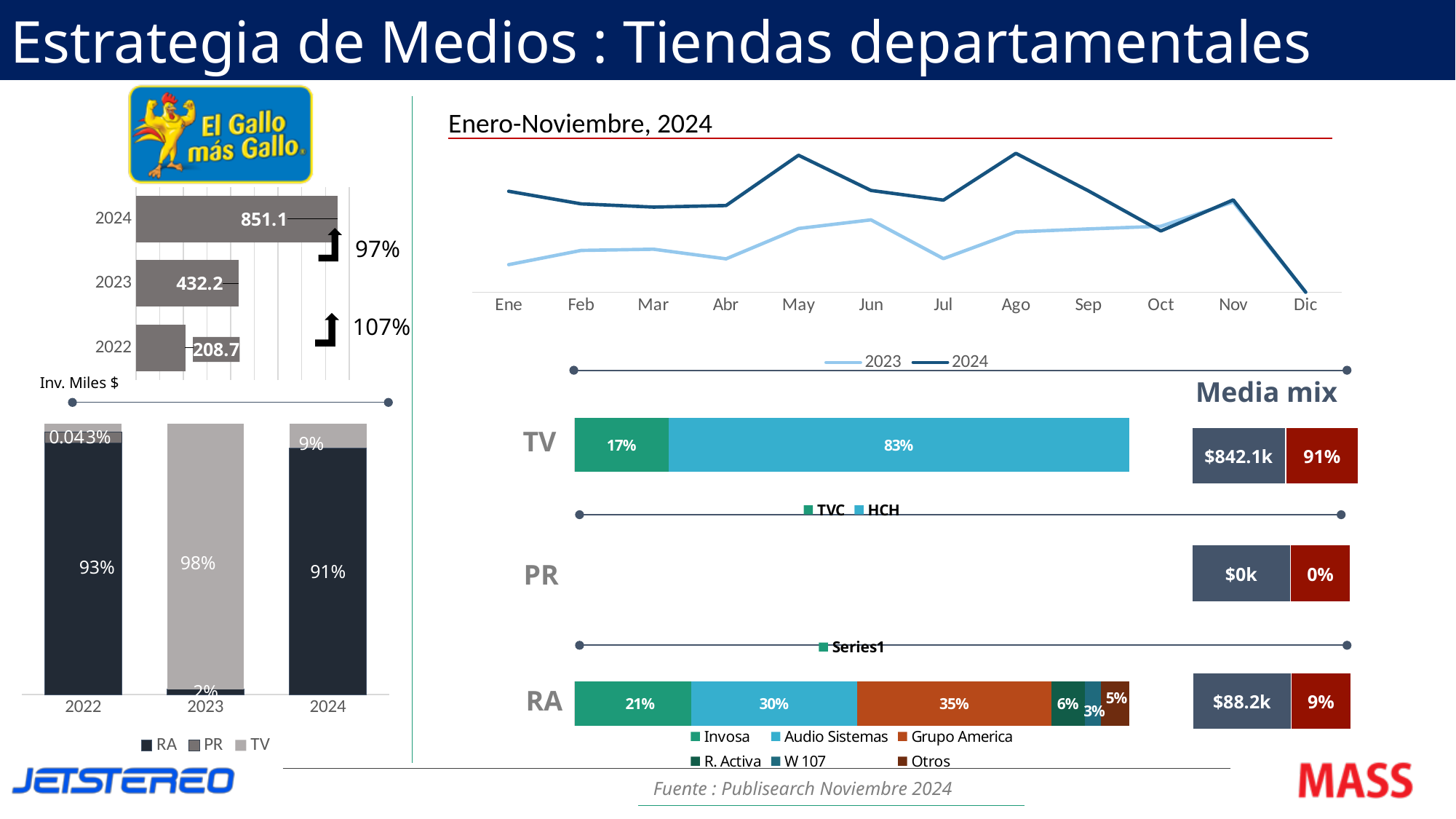
In the 'Inv. Miles $' bar chart on the left, what is the value for 2022? 208.7 In the RA stacked bar, which channel has the largest share? Grupo America In the Media mix boxes, what is the dollar amount shown for RA? $88.2k In the 'Inv. Miles $' bar chart on the left, what is the value for 2024? 851.1 In the stacked bar chart at the bottom left, what share does RA have in 2024? 91% In the 'Inv. Miles $' bar chart on the left, what is the difference between the 2024 and 2023 values? 418.9 In the stacked bar chart at the bottom left, how many series does the legend list? 3 In the 'Enero-Noviembre, 2024' line chart, which month has the lowest value for the 2024 series? Dic In the 'Inv. Miles $' bar chart on the left, which year has the lowest value? 2022 In the TV stacked bar, what share does HCH have? 83% In the 'Enero-Noviembre, 2024' line chart, how many months are shown on the x axis? 12